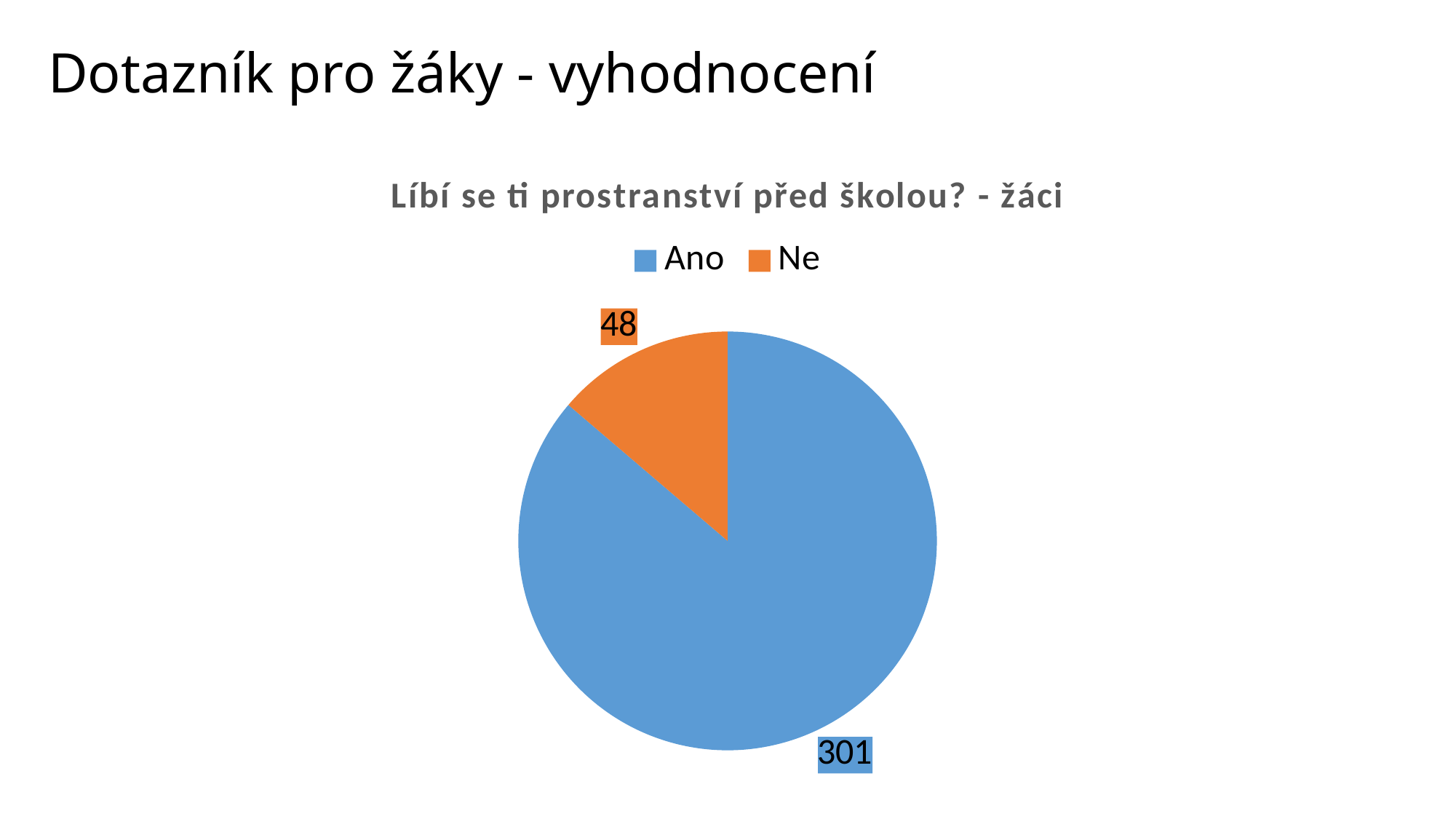
How many entries does the legend list? 2 What is the difference between the values for Ano and Ne? 253 Which category has the smallest slice? Ne What colour is the slice for Ne? orange What type of chart is shown on the slide? pie chart Which is larger, the value for Ano or the value for Ne? Ano What is the value for Ne? 48 What is the total of all slices in the pie chart? 349 What is the title of the chart? Líbí se ti prostranství před školou? - žáci What is the value for Ano? 301 Which category has the largest slice? Ano How many slices does the pie chart have? 2